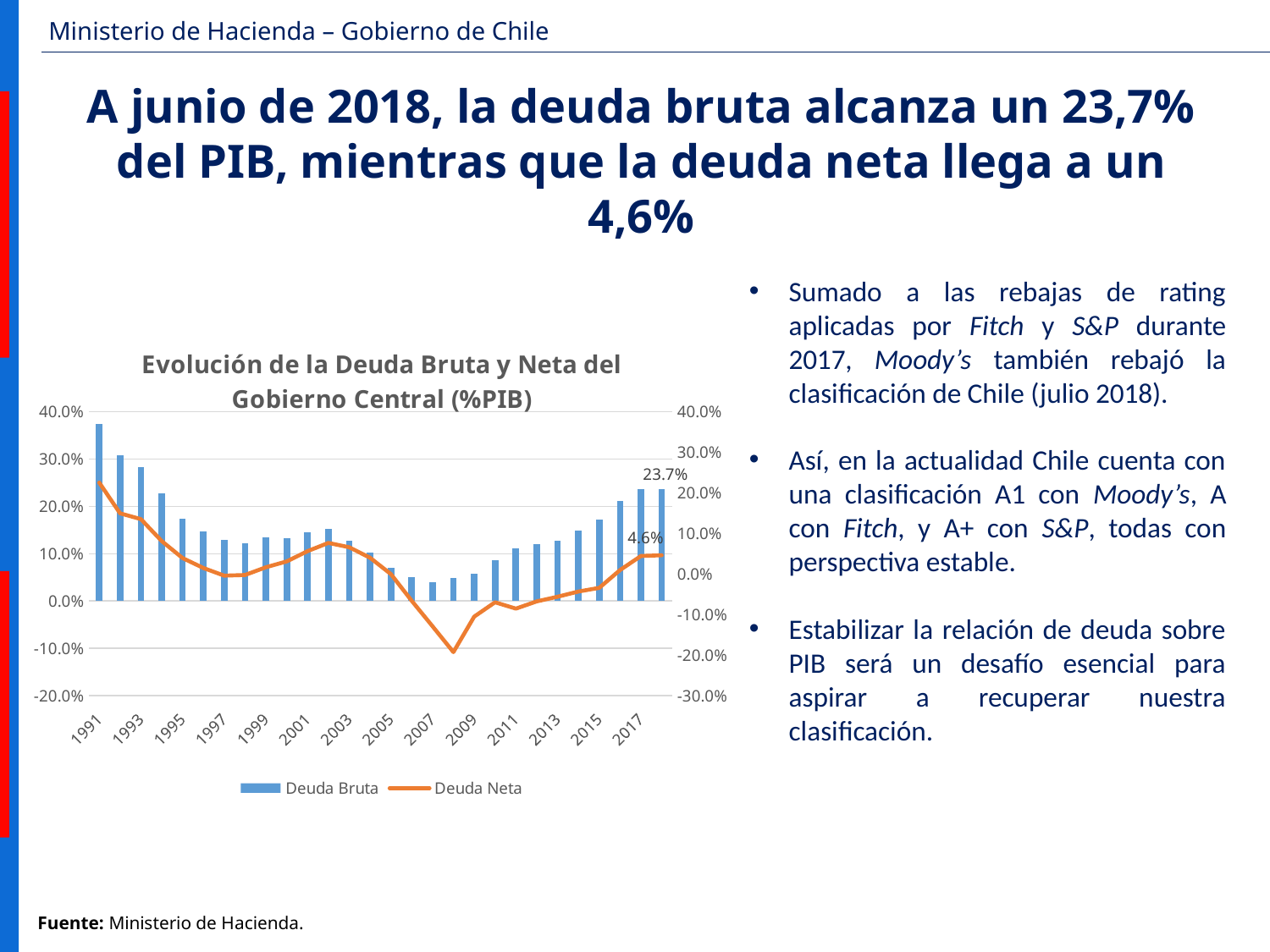
Is the Deuda Bruta value for 1991 greater or less than 30.0% on the left axis? greater Is the Deuda Bruta value for 2007 greater or less than 10.0% on the left axis? less What is the difference between the labelled final Deuda Bruta value (23.7%) and the labelled final Deuda Neta value (4.6%)? 19.1% In which year is the Deuda Bruta bar the highest? 1991 Which is larger, the Deuda Bruta bar for 1991 or the last Deuda Bruta bar labelled 23.7%? 1991 What is the value shown by the data label at the end of the Deuda Neta line? 4.6% How many series does the chart legend list? 2 What kind of chart is shown on the slide? Combined bar and line chart Which series is drawn as a line in the chart? Deuda Neta What is the value shown by the data label on the last Deuda Bruta bar? 23.7% Do the Deuda Bruta bars rise or fall from 1991 to 2007? fall What is the title of the chart? Evolución de la Deuda Bruta y Neta del Gobierno Central (%PIB)